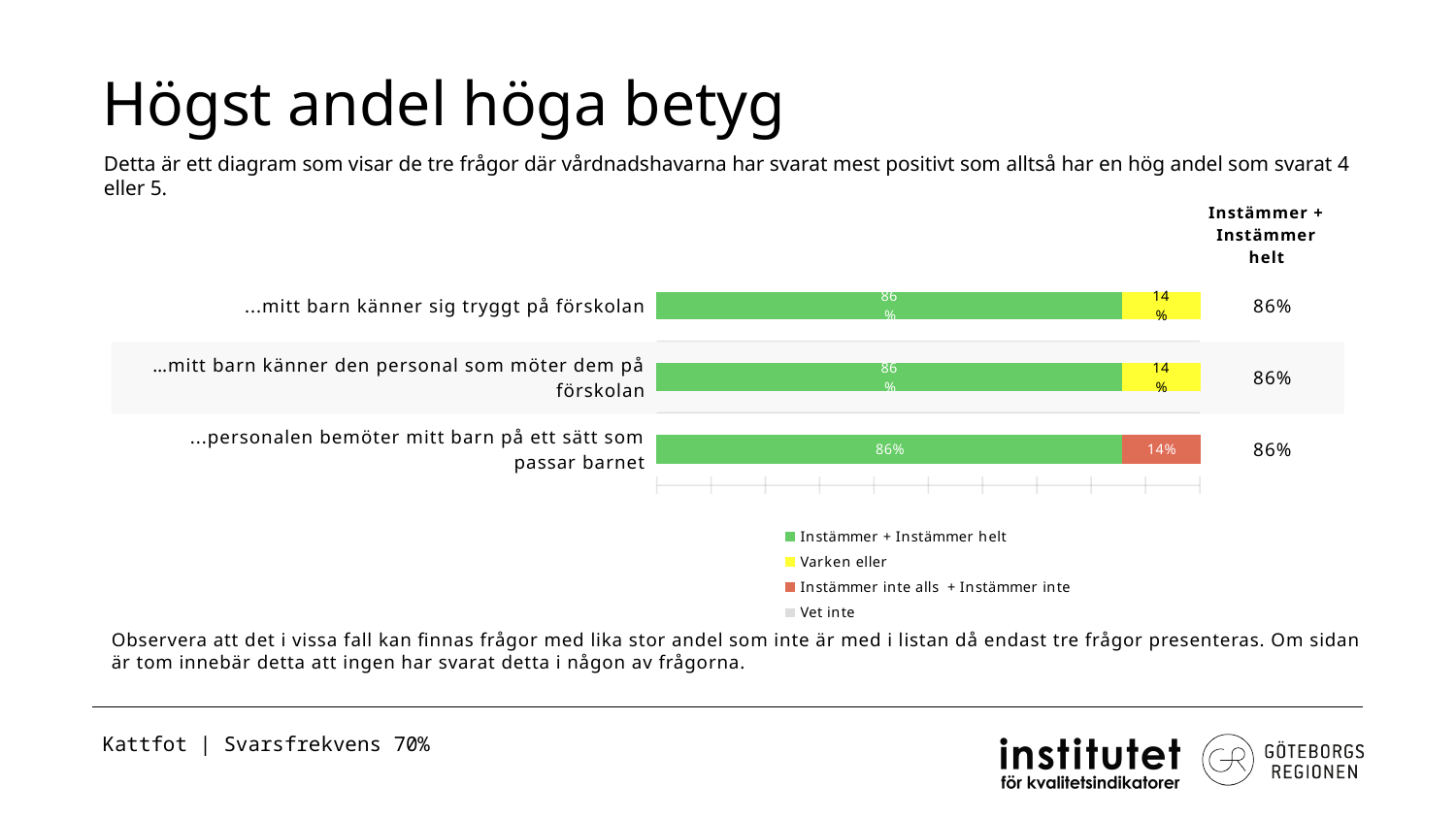
What is the 'Instämmer + Instämmer helt' value shown in the right-hand column for '...personalen bemöter mitt barn på ett sätt som passar barnet'? 86% How many series does the legend list? 4 What is the 'Instämmer + Instämmer helt' value for '...mitt barn känner sig tryggt på förskolan'? 86% What is the total of the stacked bar for '...mitt barn känner sig tryggt på förskolan'? 100% What is the difference between the 'Instämmer + Instämmer helt' and 'Varken eller' values for '...mitt barn känner sig tryggt på förskolan'? 72% What kind of chart is shown on the slide? bar chart Which colour represents 'Varken eller' in the legend? yellow What is the 'Instämmer inte alls + Instämmer inte' value for '...personalen bemöter mitt barn på ett sätt som passar barnet'? 14% Which is larger for '...personalen bemöter mitt barn på ett sätt som passar barnet': the 'Instämmer + Instämmer helt' share or the 'Instämmer inte alls + Instämmer inte' share? Instämmer + Instämmer helt What is the 'Varken eller' value for '...mitt barn känner den personal som möter dem på förskolan'? 14% What is the title of the slide containing the chart? Högst andel höga betyg How many questions (categories) are plotted in the chart? 3